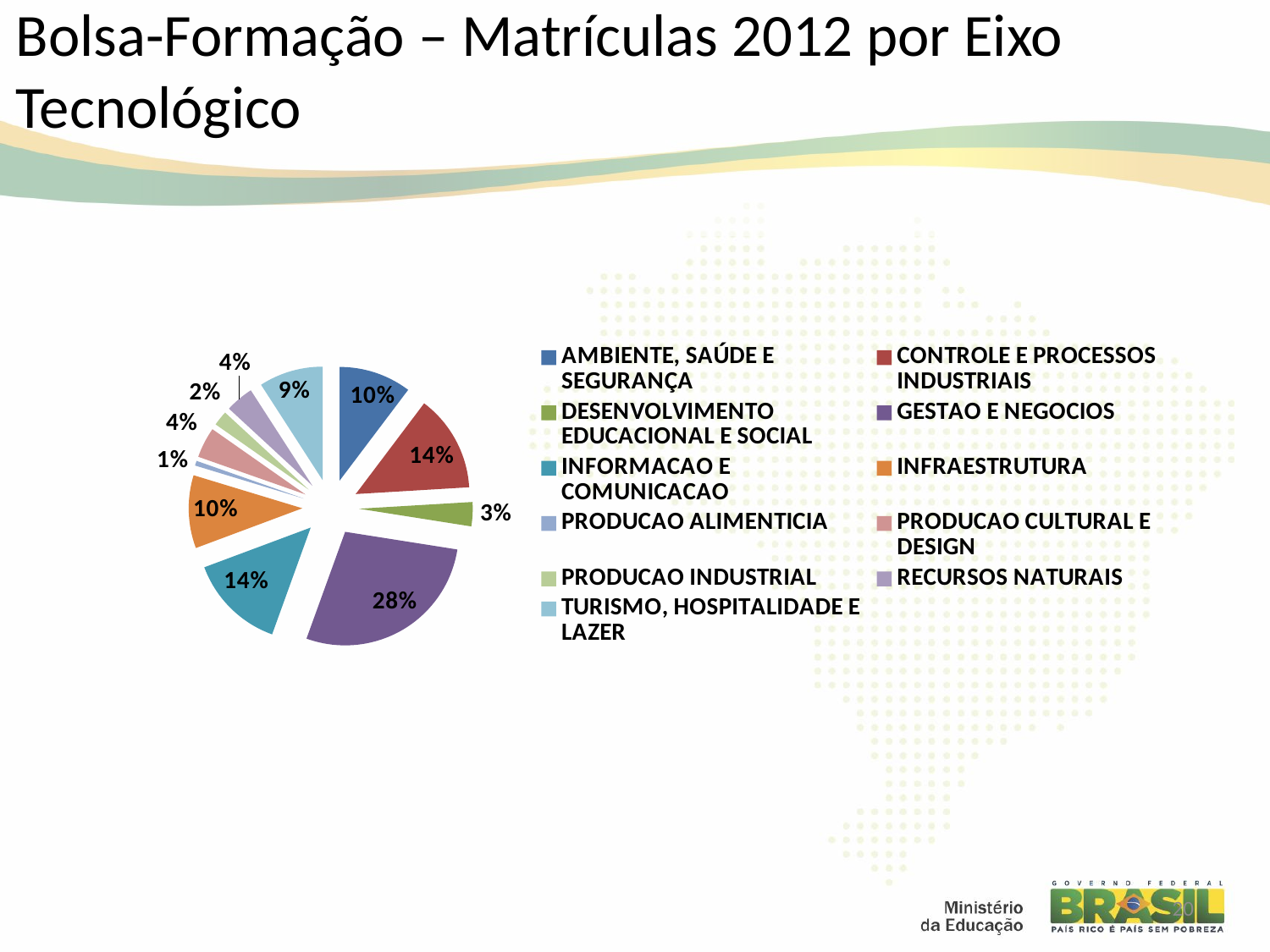
What share of the pie does GESTAO E NEGOCIOS have? 28% What is the title of the slide containing the chart? Bolsa-Formação – Matrículas 2012 por Eixo Tecnológico Which has a larger share, CONTROLE E PROCESSOS INDUSTRIAIS or AMBIENTE, SAÚDE E SEGURANÇA? CONTROLE E PROCESSOS INDUSTRIAIS What share of the pie does TURISMO, HOSPITALIDADE E LAZER have? 9% Which category has the smallest share of the pie? PRODUCAO ALIMENTICIA What kind of chart is shown on the slide? pie chart Which category has the largest share of the pie? GESTAO E NEGOCIOS Which has a larger share, PRODUCAO CULTURAL E DESIGN or PRODUCAO INDUSTRIAL? PRODUCAO CULTURAL E DESIGN How many categories does the pie chart show? 11 What is the difference between the shares of GESTAO E NEGOCIOS and INFORMACAO E COMUNICACAO? 14% What share of the pie does DESENVOLVIMENTO EDUCACIONAL E SOCIAL have? 3%